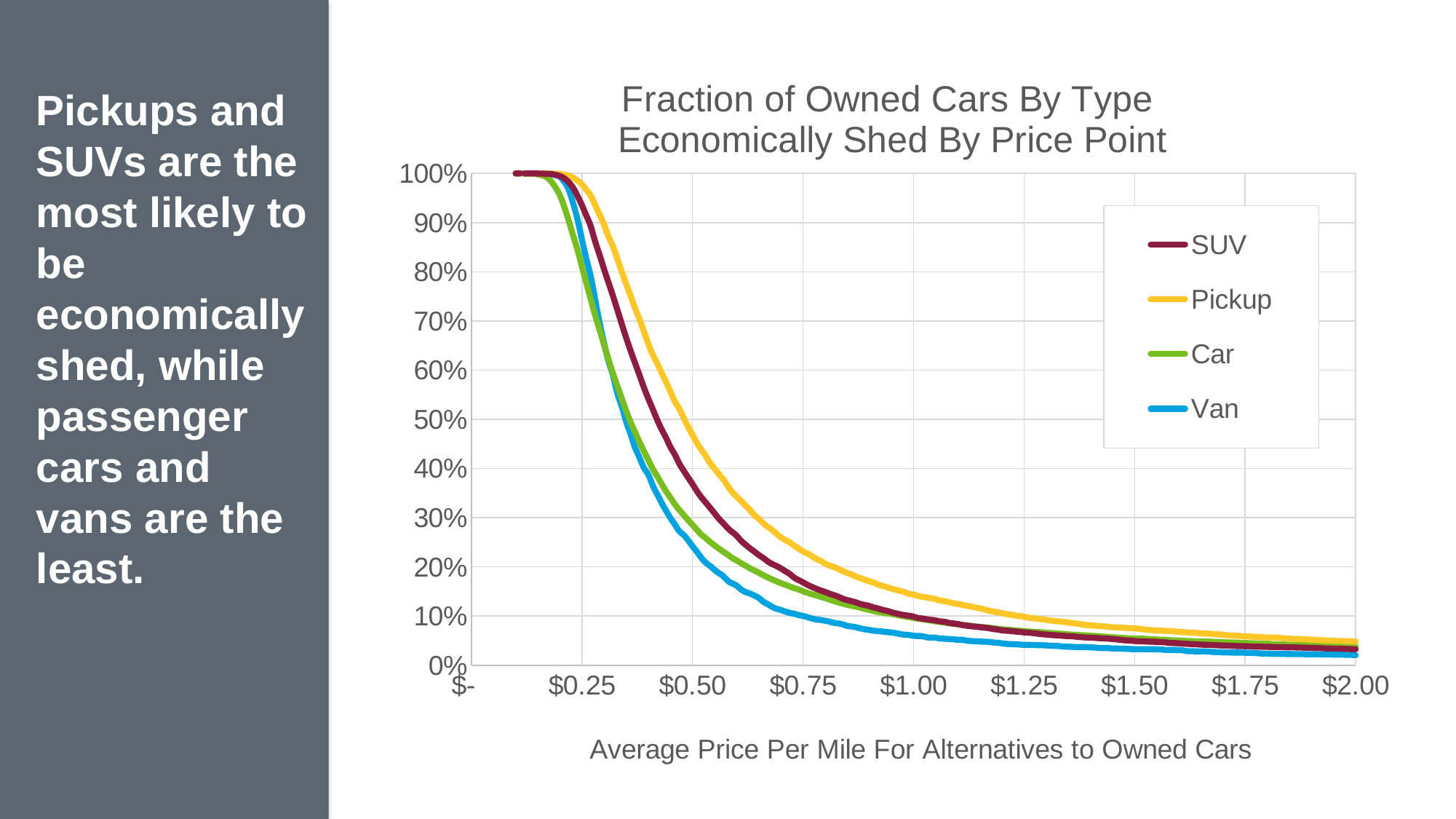
What is the label of the x axis? Average Price Per Mile For Alternatives to Owned Cars Is the value for SUV at $0.25 greater or less than 90%? greater Do the values for SUV rise or fall as the price per mile increases along the x axis? fall How many series does the legend list? 4 Is the value for Van at $1.00 greater or less than 10%? less Is the value for Pickup at $0.75 greater or less than 20%? greater What kind of chart is shown on the slide? line chart At $0.50, which is larger: the value for Pickup or the value for Van? Pickup Which series is lowest at $1.00 on the x axis? Van What is the title of the chart? Fraction of Owned Cars By Type Economically Shed By Price Point Which series is highest at $1.00 on the x axis? Pickup